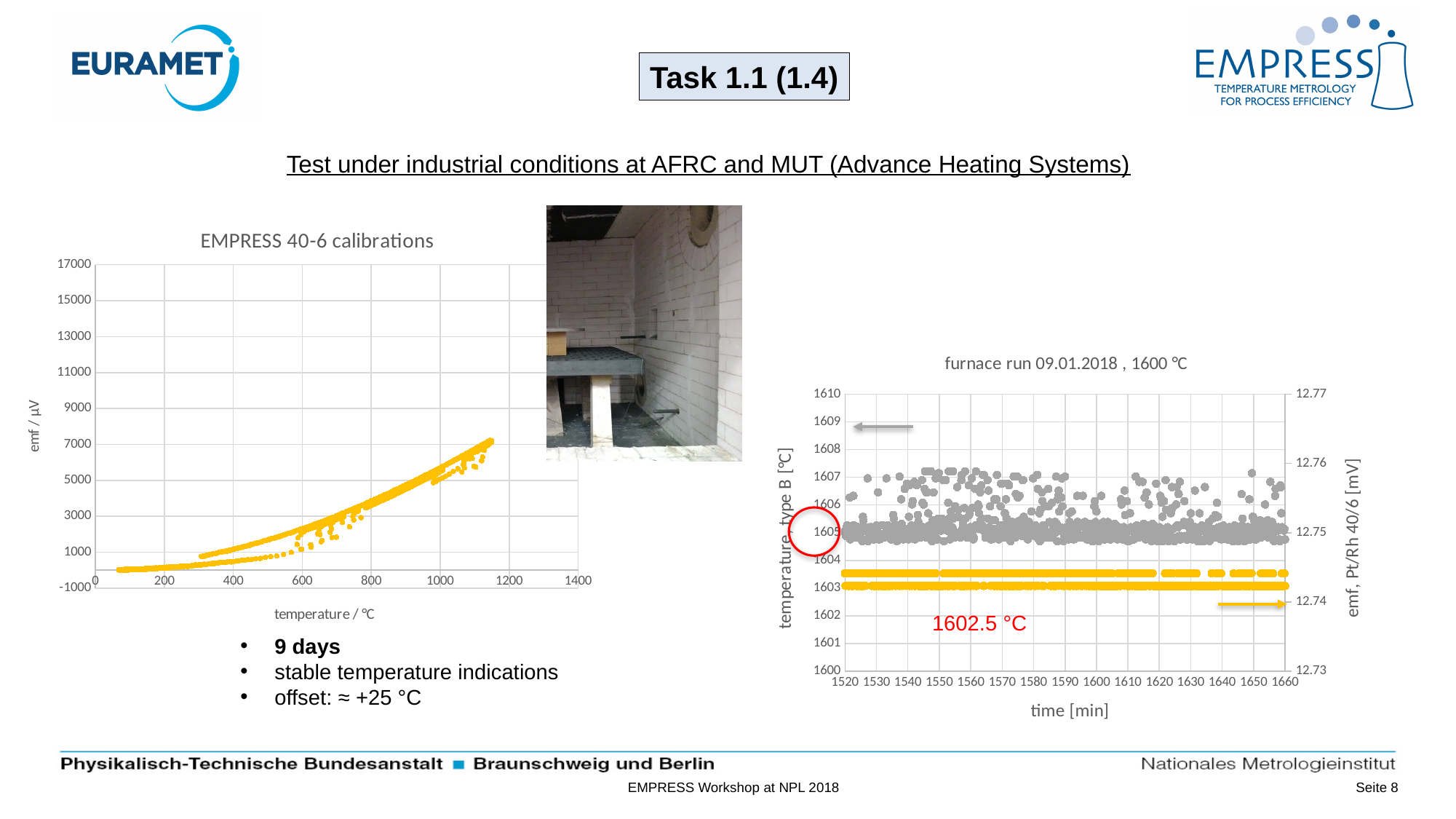
How many charts are shown on the slide? 2 In the 'EMPRESS 40-6 calibrations' chart, is the emf value at 1000 °C greater or less than 7000? less What kind of chart is the 'furnace run 09.01.2018 , 1600 °C' chart? scatter chart In the 'EMPRESS 40-6 calibrations' chart, is the emf value at 1100 °C greater or less than 5000? greater In the 'furnace run 09.01.2018 , 1600 °C' chart, do the grey temperature values rise, fall, or stay roughly constant over time? stay roughly constant What temperature value is annotated in red on the 'furnace run 09.01.2018 , 1600 °C' chart? 1602.5 °C What is the x-axis label of the 'EMPRESS 40-6 calibrations' chart? temperature / °C In the 'EMPRESS 40-6 calibrations' chart, do the emf values rise or fall as temperature increases along the x axis? rise In the 'EMPRESS 40-6 calibrations' chart, is the emf value at 600 °C greater or less than 3000? less What is the title of the chart on the right of the slide? furnace run 09.01.2018 , 1600 °C What kind of chart is the 'EMPRESS 40-6 calibrations' chart? scatter chart